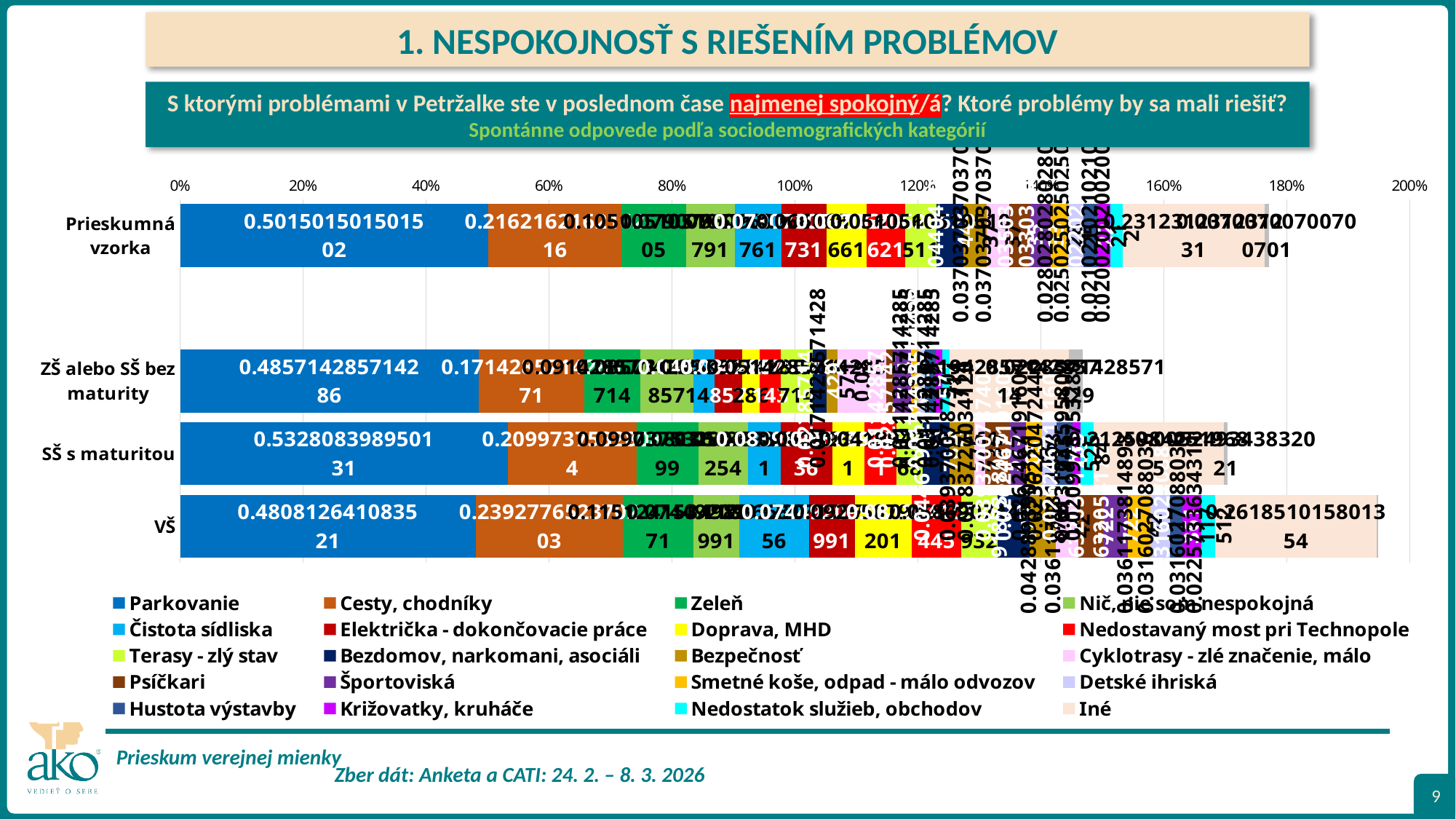
Which colour represents Parkovanie in the legend? blue Which category has the lowest value for Parkovanie? VŠ How many series does the legend list? 20 What is the value of Parkovanie for SŠ s maturitou? 0.532808398950131 What is the value of Cesty, chodníky for ZŠ alebo SŠ bez maturity? 0.171428571428571 For Prieskumná vzorka, which is larger: Parkovanie or Cesty, chodníky? Parkovanie What kind of chart is shown on the slide? stacked bar chart Is the Parkovanie value for ZŠ alebo SŠ bez maturity greater or less than 40%? greater How many categories (rows) does the chart show? 4 What is the value of Parkovanie for VŠ? 0.480812641083521 What is the value of Parkovanie for Prieskumná vzorka? 0.501501501501502 Which category has the highest value for Parkovanie? SŠ s maturitou